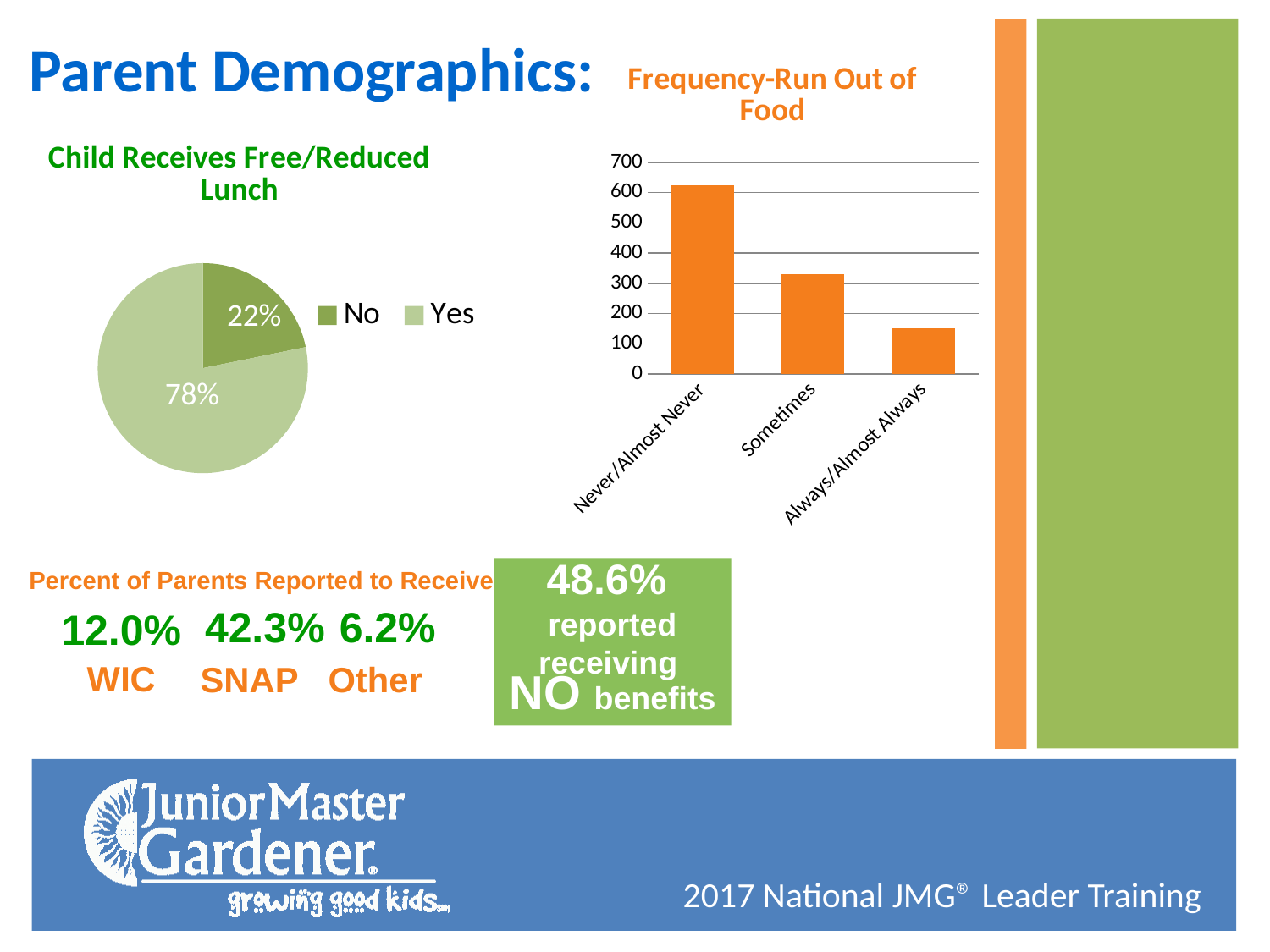
In the 'Frequency-Run Out of Food' chart, do the values rise or fall from left to right along the x axis? Fall What kind of chart is 'Frequency-Run Out of Food'? Bar chart In the 'Child Receives Free/Reduced Lunch' chart, what is the difference in percentage points between the 'Yes' and 'No' slices? 56 In the 'Child Receives Free/Reduced Lunch' chart, which slice is larger, 'No' or 'Yes'? Yes In the 'Frequency-Run Out of Food' chart, which category has the highest value? Never/Almost Never What kind of chart is 'Child Receives Free/Reduced Lunch'? Pie chart In the 'Child Receives Free/Reduced Lunch' chart, what is the share for 'No'? 22% How many entries does the legend of the 'Child Receives Free/Reduced Lunch' chart list? 2 In the 'Child Receives Free/Reduced Lunch' chart, what percentage of children receive free/reduced lunch (Yes)? 78% In the 'Frequency-Run Out of Food' chart, is the value for 'Sometimes' greater or less than 400? less In the 'Frequency-Run Out of Food' chart, which category has the lowest value? Always/Almost Always How many categories are shown in the 'Frequency-Run Out of Food' chart? 3